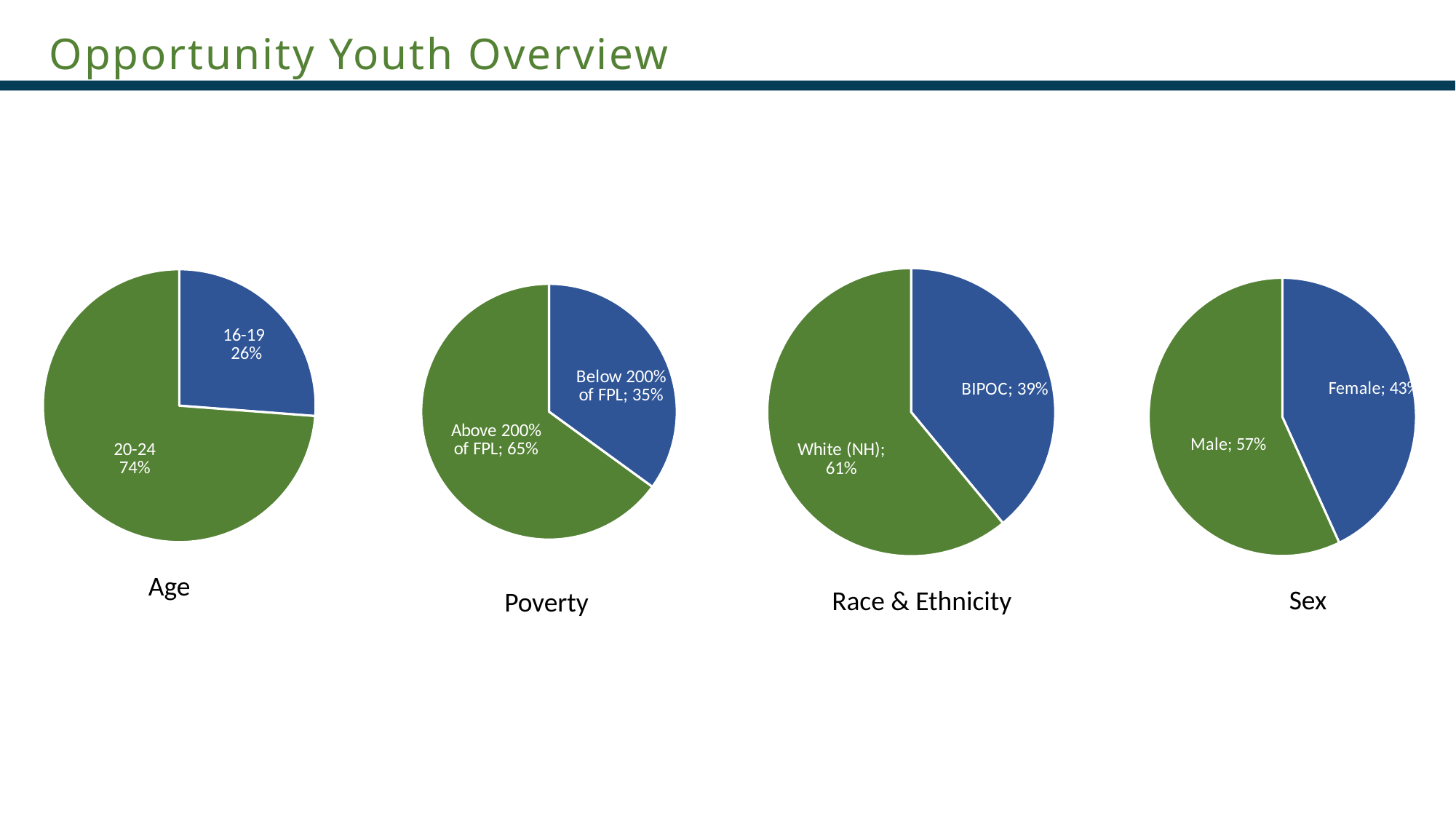
In the Sex pie chart, which slice is larger, Male or Female? Male In the Age pie chart, what share is the 20-24 slice? 74% In the Race & Ethnicity pie chart, what share is White (NH)? 61% In the Age pie chart, what share is the 16-19 slice? 26% In the Poverty pie chart, what share is Below 200% of FPL? 35% In the Age pie chart, what is the difference between the 20-24 and 16-19 shares? 48% How many slices does the Poverty pie chart have? 2 In the Sex pie chart, what share is Male? 57% In the Race & Ethnicity pie chart, which category is the largest? White (NH) What type of chart is used for the Sex chart? Pie chart In the Race & Ethnicity pie chart, what share is BIPOC? 39% In the Poverty pie chart, what share is Above 200% of FPL? 65%